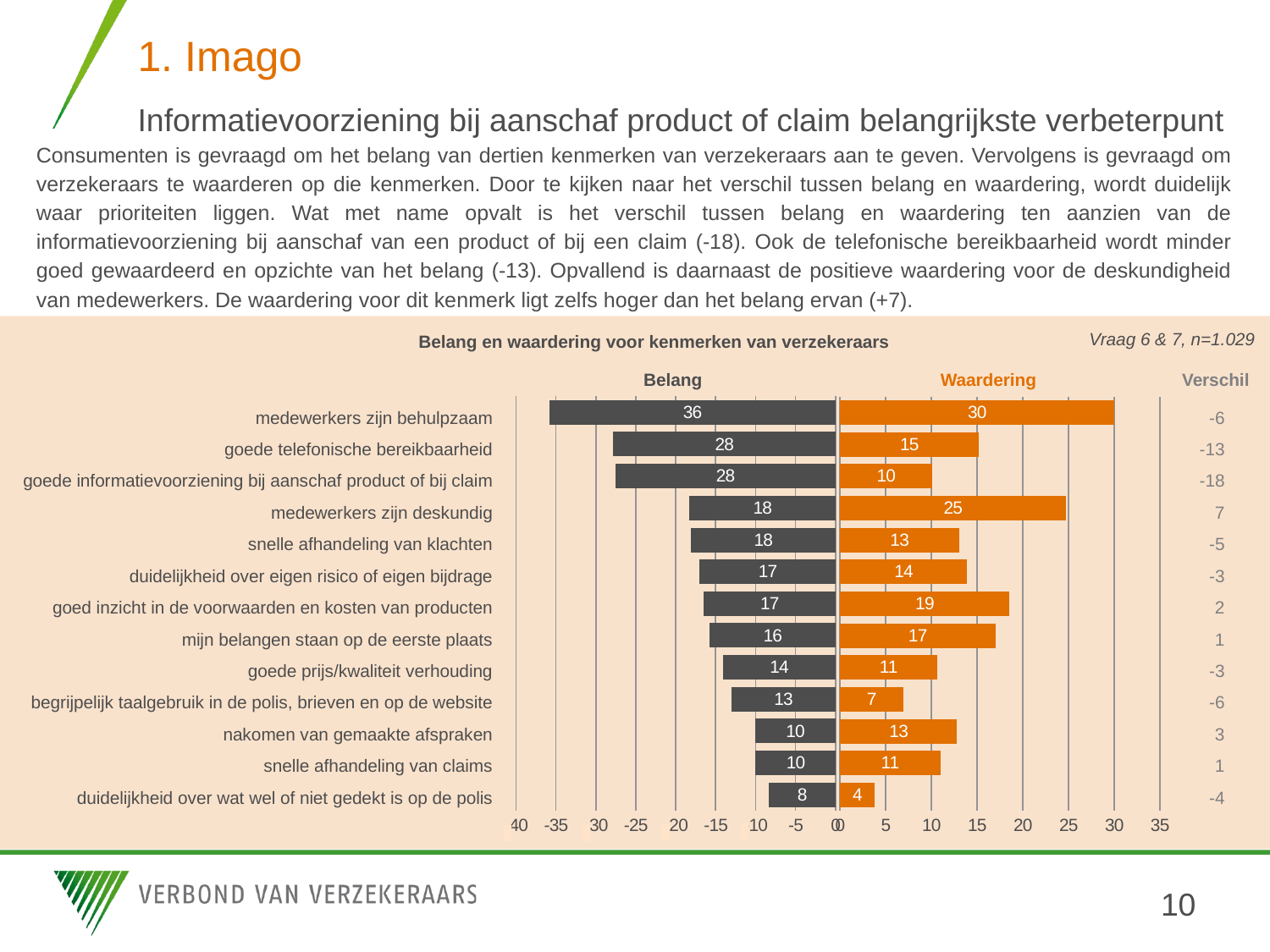
What type of chart is shown on the slide? bar chart Which category has the lowest Waardering value? duidelijkheid over wat wel of niet gedekt is op de polis How many categories are shown in the chart? 13 What is the Waardering value for 'medewerkers zijn deskundig'? 25 What is the difference between the Belang and Waardering values for 'goede telefonische bereikbaarheid'? 13 How many series does the chart show? 2 What is the title of the chart? Belang en waardering voor kenmerken van verzekeraars What is the Belang value for 'medewerkers zijn behulpzaam'? 36 Which category has the highest Belang value? medewerkers zijn behulpzaam What is the Waardering value for 'goede informatievoorziening bij aanschaf product of bij claim'? 10 Which is larger for 'nakomen van gemaakte afspraken': the Belang value or the Waardering value? Waardering Which colour represents the Waardering series? orange